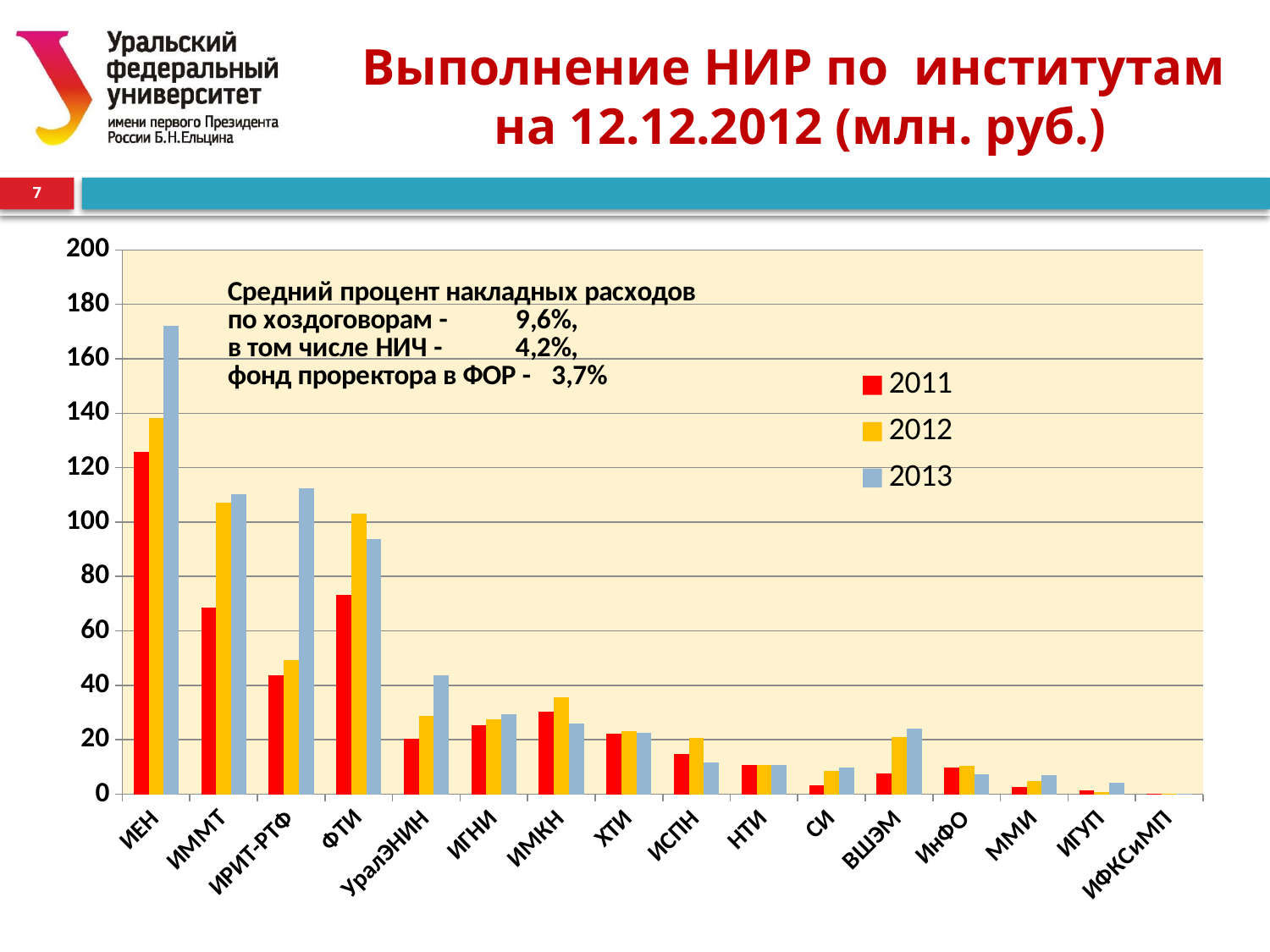
Which colour represents the 2012 series in the legend? yellow Do the 2011 values generally rise or fall from left to right along the x axis? fall Which is larger for ФТИ: the 2012 value or the 2013 value? 2012 Is the 2012 value for ИМКН greater or less than 40? less Which institute has the lowest values on the chart? ИФКСиМП Is the 2013 value for ИЕН greater or less than 160? greater How many institutes (categories) are shown on the x axis? 16 What kind of chart is shown on the slide? bar chart Which institute has the tallest bar on the chart? ИЕН How many series does the legend list? 3 Is the 2013 value for ИРИТ-РТФ greater or less than 100? greater